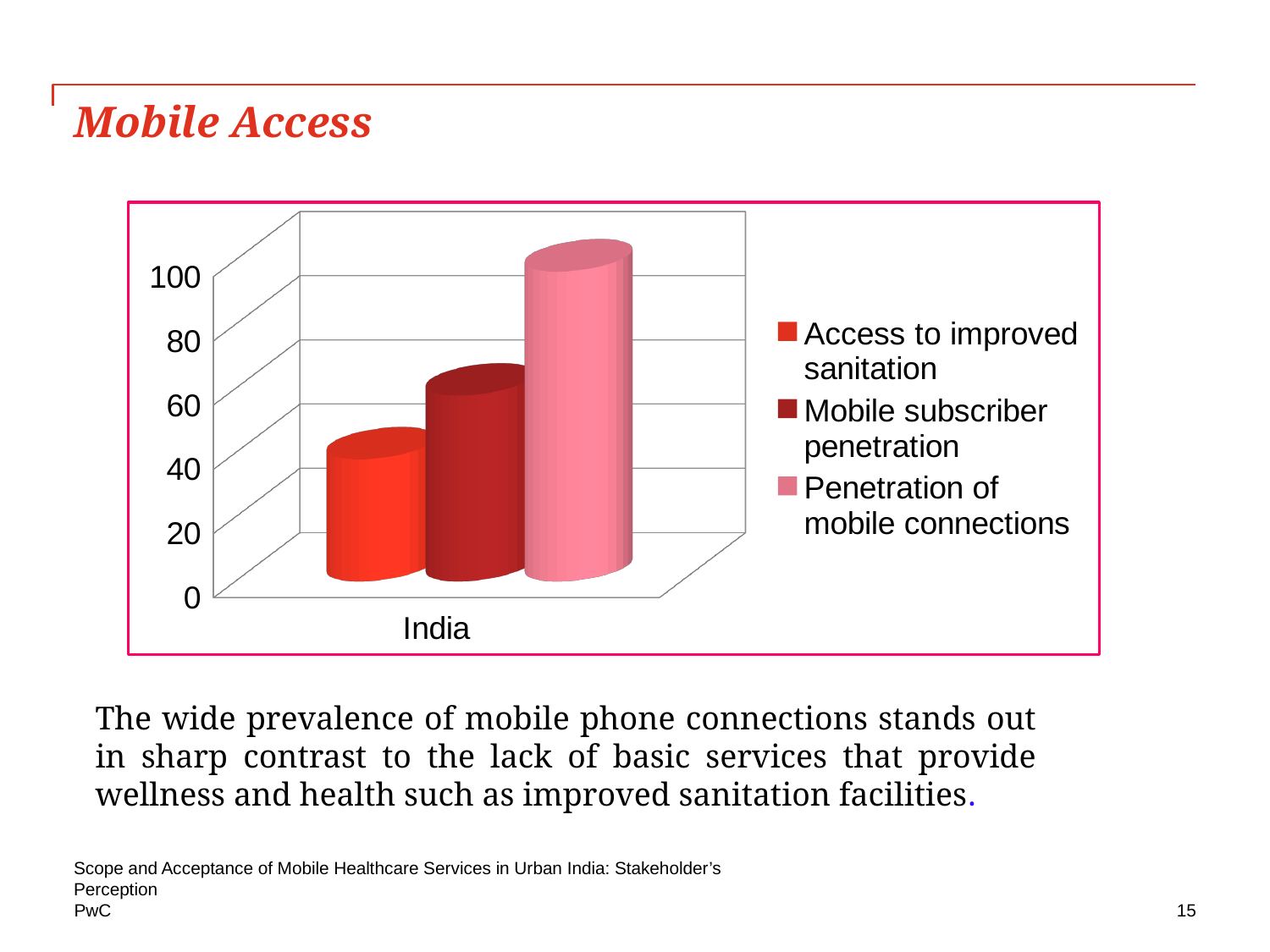
Which is larger for India: Penetration of mobile connections or Mobile subscriber penetration? Penetration of mobile connections Which series has the highest value for India? Penetration of mobile connections Is the value for Penetration of mobile connections greater or less than 80? greater Which is larger for India: Mobile subscriber penetration or Access to improved sanitation? Mobile subscriber penetration Is the value for Mobile subscriber penetration greater or less than 40? greater Which category is shown on the x axis? India Is the value for Access to improved sanitation greater or less than 60? less How many categories are shown on the x axis? 1 Which series is shown in light pink in the legend? Penetration of mobile connections How many series does the legend list? 3 What kind of chart is shown on the slide? bar chart Which series has the lowest value for India? Access to improved sanitation